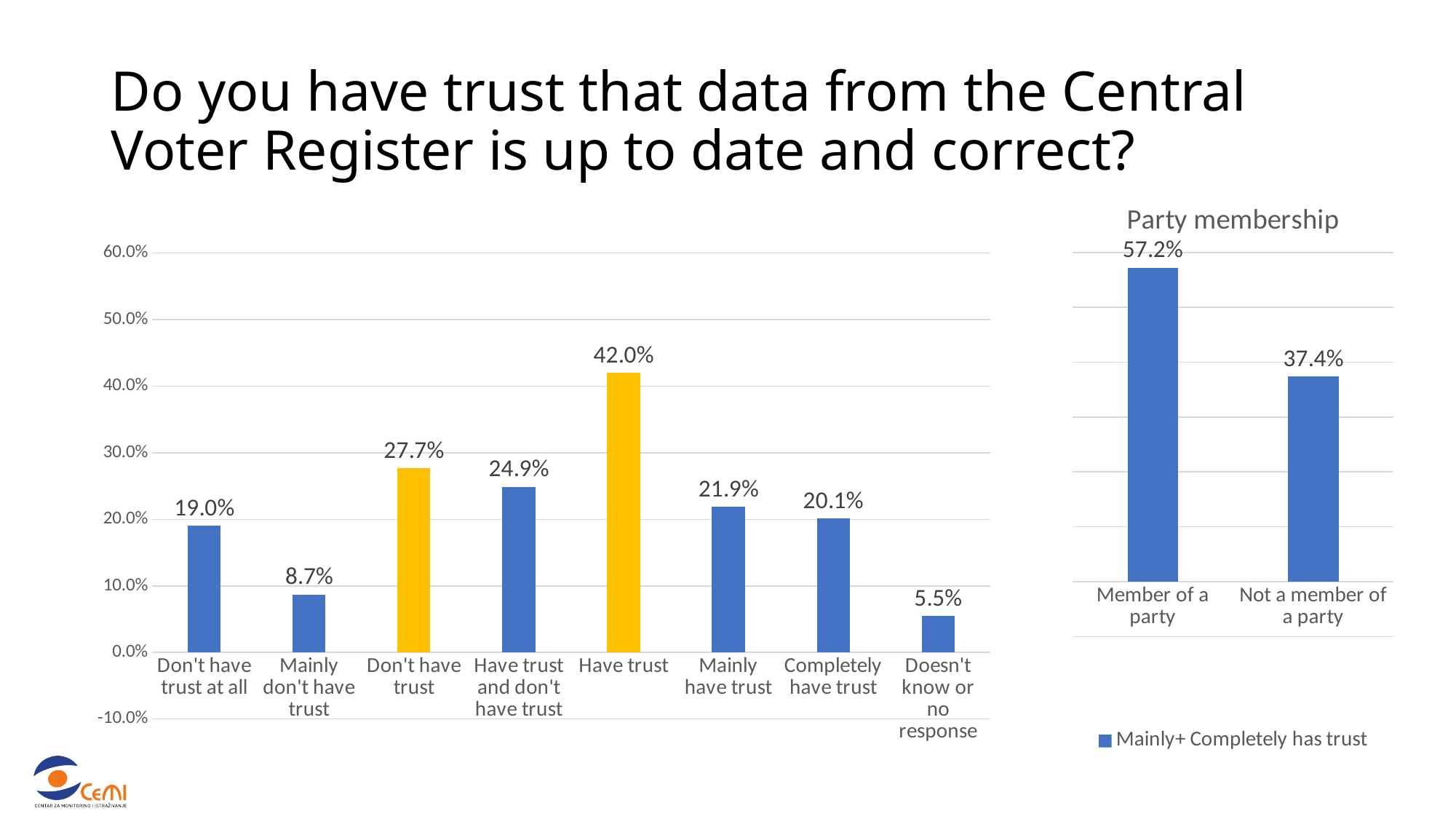
How many categories are shown in the left chart? 8 In the 'Party membership' chart, what is the difference between 'Member of a party' and 'Not a member of a party'? 19.8% In the left chart, which category has the highest value? Have trust In the 'Party membership' chart, which category has the higher value? Member of a party In the left chart, what is the value for 'Have trust'? 42.0% In the 'Party membership' chart, what is the value for 'Member of a party'? 57.2% What type of chart is the 'Party membership' chart? Bar chart In the left chart, which category has the lowest value? Doesn't know or no response In the left chart, what is the value for 'Mainly don't have trust'? 8.7% What series name does the legend of the 'Party membership' chart show? Mainly+ Completely has trust In the left chart, which is larger: 'Don't have trust at all' or 'Completely have trust'? Completely have trust In the left chart, what is the difference between 'Have trust' and 'Don't have trust'? 14.3%